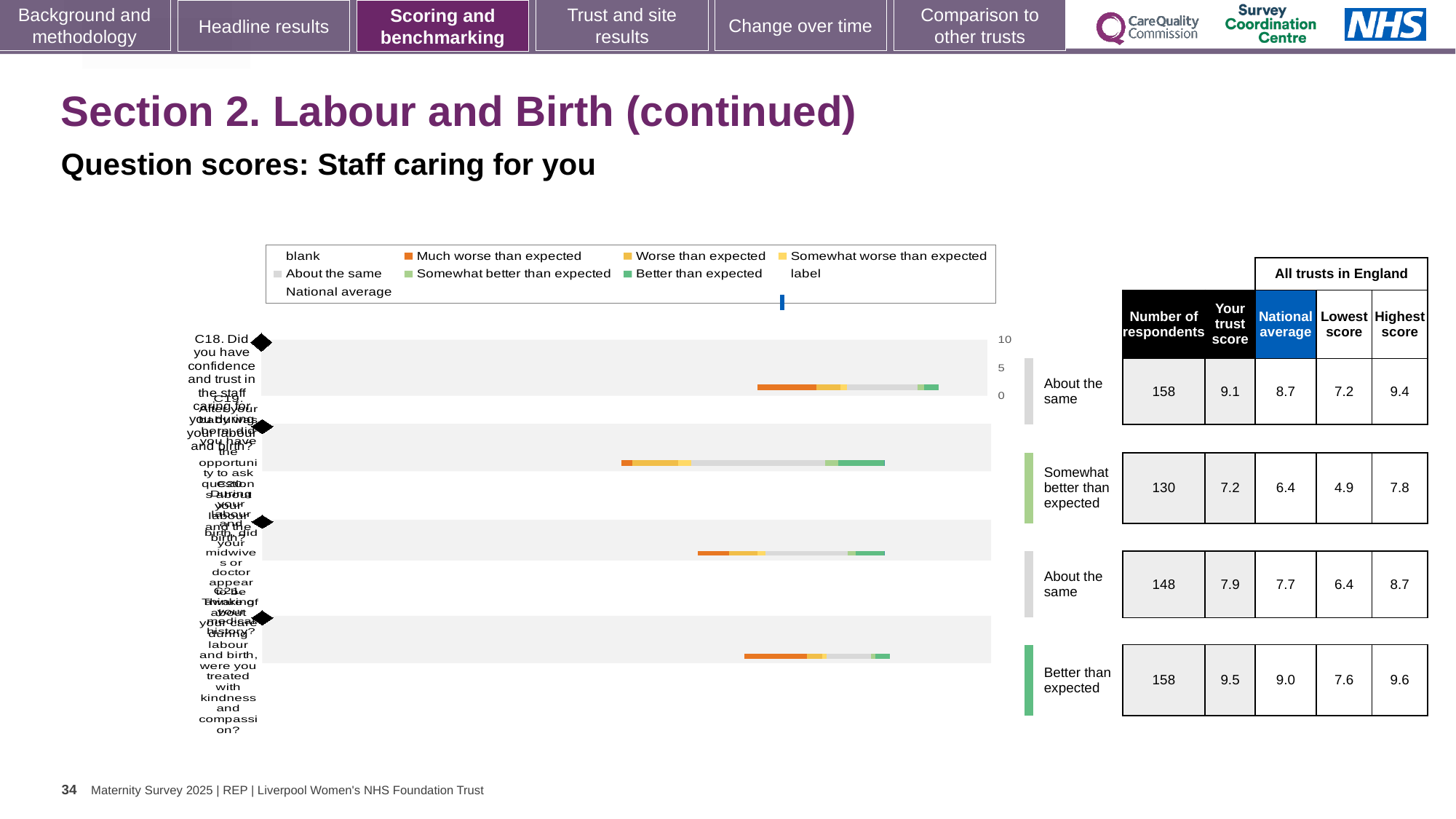
What is the subtitle describing the question scores shown on the slide? Question scores: Staff caring for you What kind of chart is shown on the slide? Bar chart What is the highest score in England for the third row (C20, rated 'About the same' with 148 respondents)? 8.7 What is the national average for the row rated 'Somewhat better than expected'? 6.4 For the last row (C21), how much higher is the trust score than the national average? 0.5 Which row has the highest 'Your trust score'? C21 (Better than expected), 9.5 Which row has the lowest 'Your trust score'? C19 (Somewhat better than expected), 7.2 What is the 'Your trust score' for the first row (C18, confidence and trust in staff)? 9.1 What is the lowest score in England for the row rated 'Somewhat better than expected'? 4.9 How many questions (bars) are plotted in the chart? 4 How many respondents are listed for the last row (C21, treated with kindness and compassion)? 158 For the first row (C18), which is larger: the trust score or the national average? The trust score (9.1)